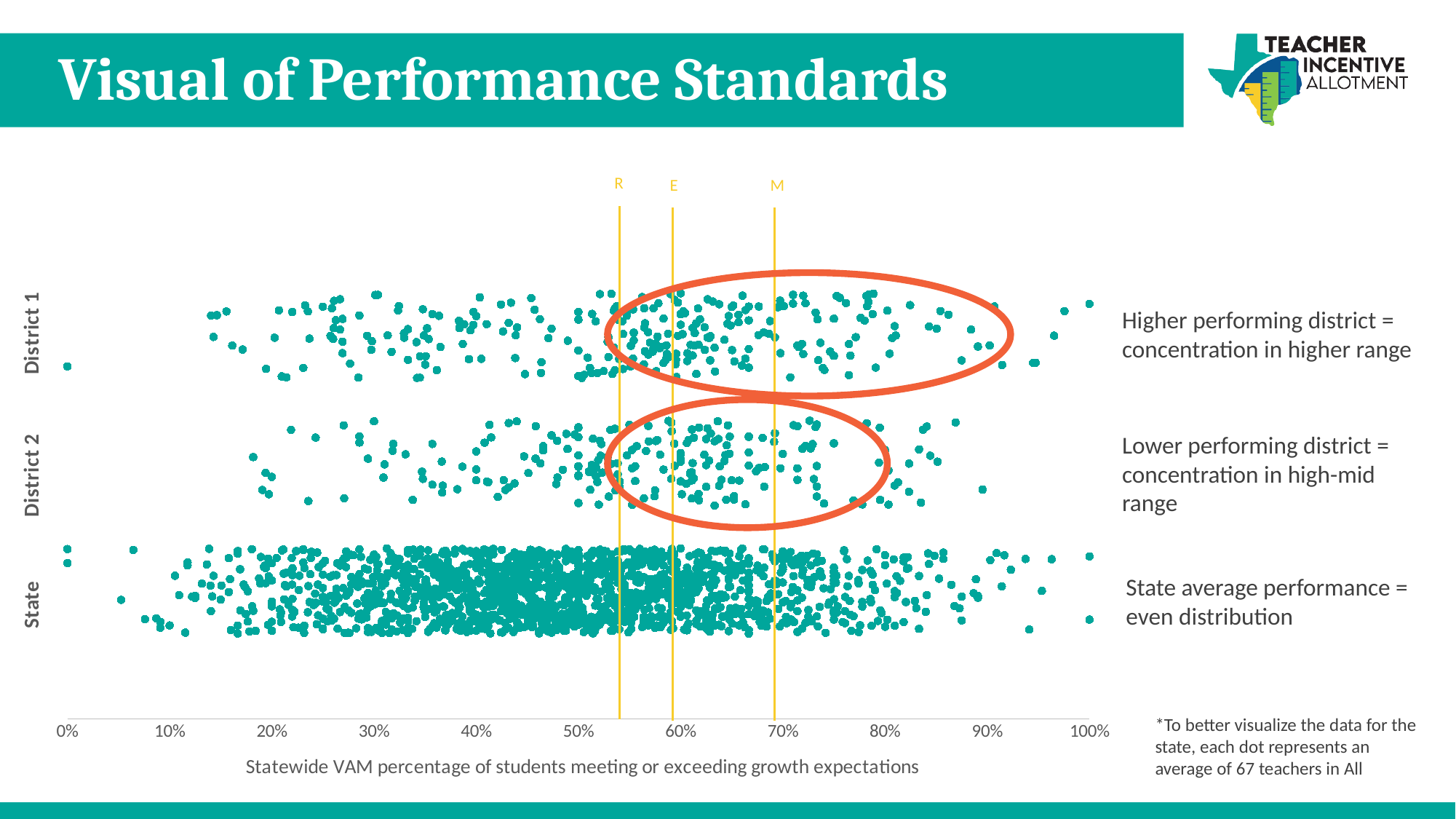
Is the vertical line labelled R positioned at a value greater or less than 50%? greater What is the x-axis label of the chart? Statewide VAM percentage of students meeting or exceeding growth expectations Which row of the chart contains the most dots? State Which district's dots are concentrated in the higher range, District 1 or District 2? District 1 What are the three categories plotted on the y axis? District 1, District 2, State According to the footnote, how many teachers does each dot in the State row represent on average? 67 What is the highest value shown on the x axis of the chart? 100% Is the vertical line labelled M positioned at a value greater or less than 60%? greater What is the title of the slide containing the chart? Visual of Performance Standards What kind of chart is shown on the slide? scatter plot (dot plot) How many categories (rows) are plotted on the y axis of the chart? 3